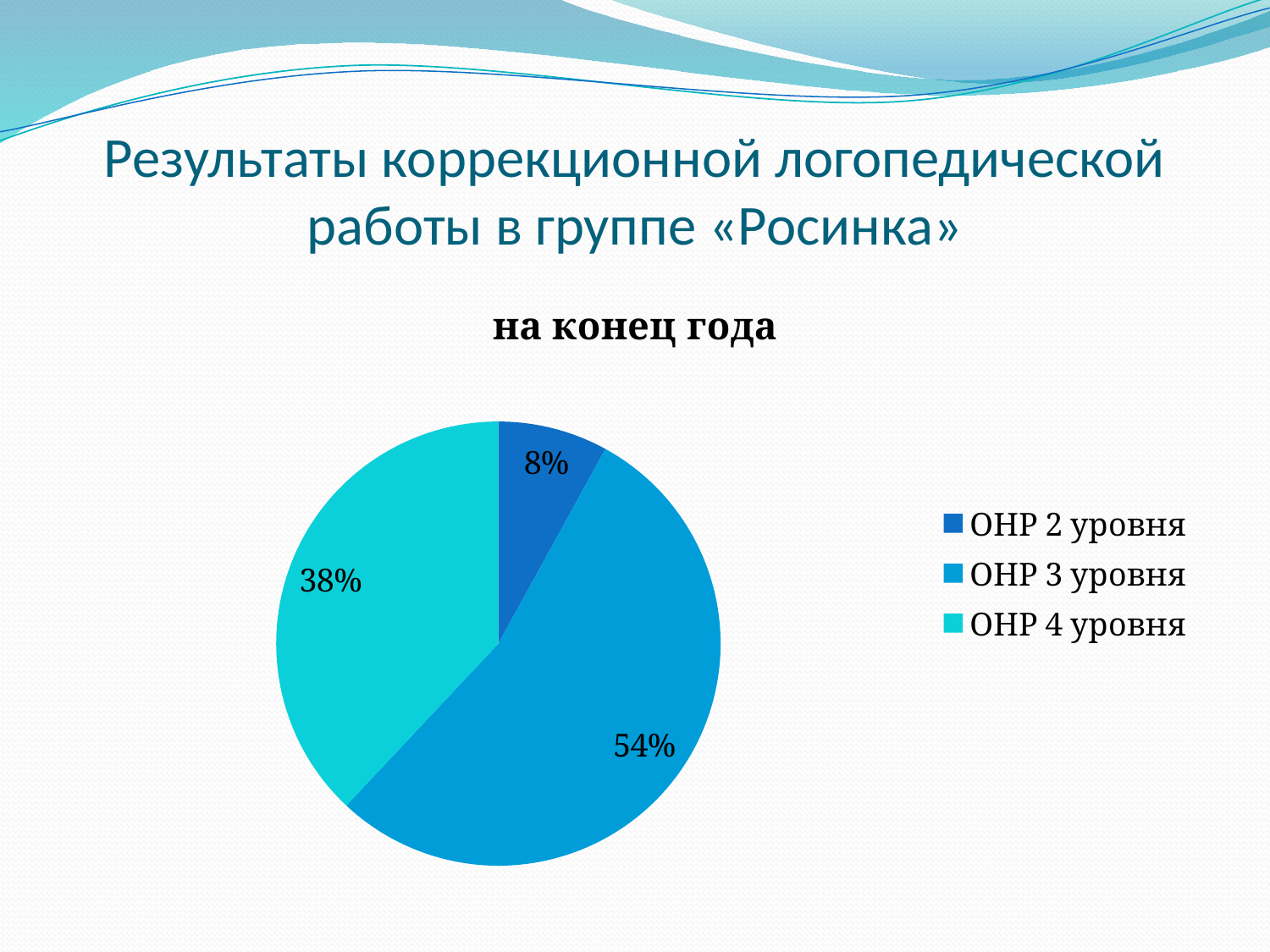
Which is larger, the slice for ОНР 4 уровня or the slice for ОНР 2 уровня? ОНР 4 уровня What kind of chart is shown on the slide? pie chart What is the title of the chart? на конец года What share of the pie does ОНР 2 уровня have? 8% Which category has the smallest slice of the pie? ОНР 2 уровня What share of the pie does ОНР 3 уровня have? 54% What share of the pie does ОНР 4 уровня have? 38% Which category has the largest slice of the pie? ОНР 3 уровня What is the difference in percentage points between ОНР 3 уровня and ОНР 4 уровня? 16 How many entries does the legend list? 3 How many slices does the pie chart have? 3 What is the difference in percentage points between ОНР 4 уровня and ОНР 2 уровня? 30